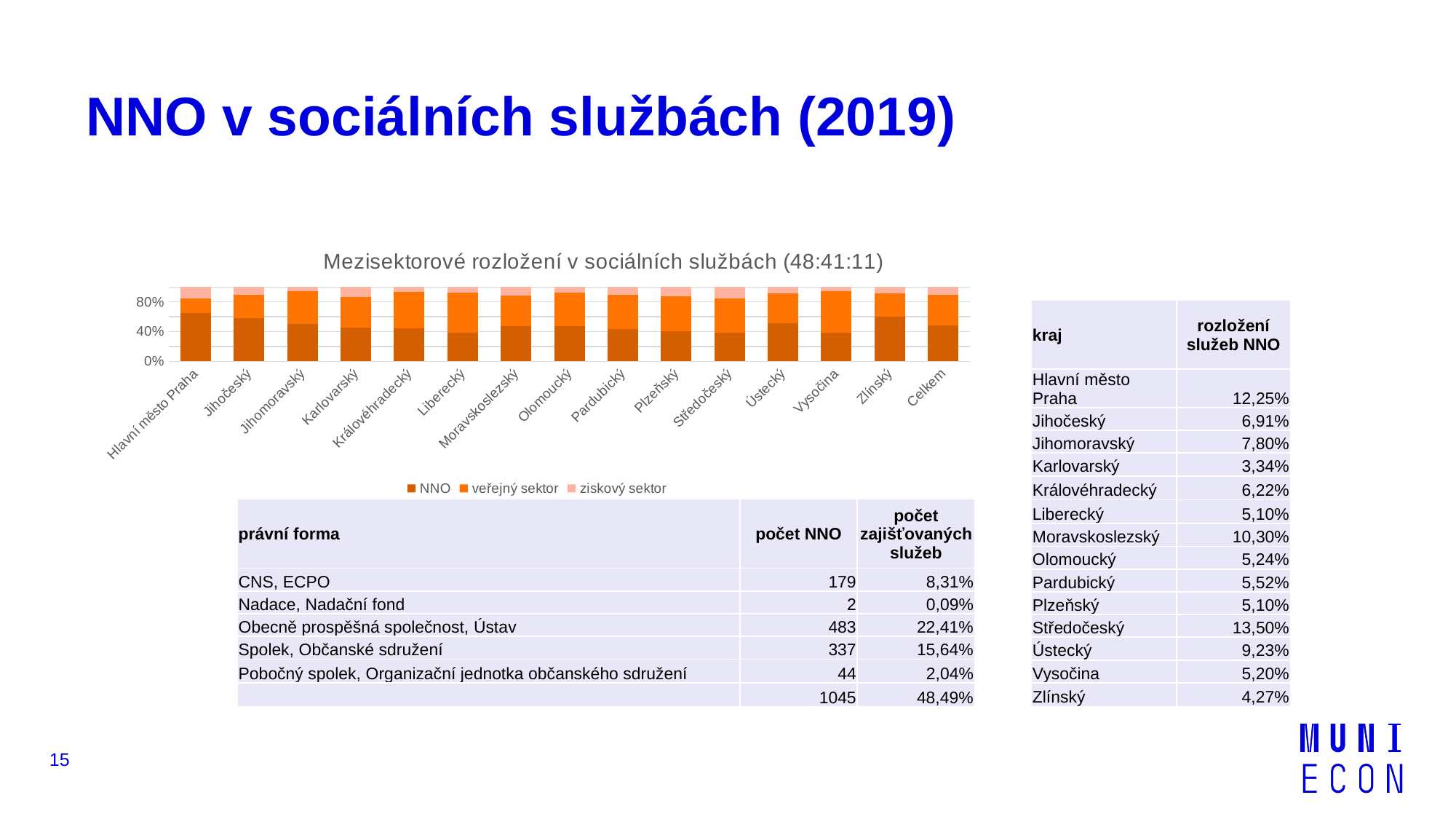
Is the NNO value for Hlavní město Praha greater or less than 40%? greater How many categories are shown on the x axis of the chart? 15 Which category has the highest NNO share in the chart? Hlavní město Praha Is the NNO value for Zlínský greater or less than 40%? greater Is the NNO value for Celkem greater or less than 80%? less Which has the larger NNO share: Jihomoravský or Liberecký? Jihomoravský What kind of chart is shown on the slide? stacked bar chart How many series does the chart legend list? 3 Which series is plotted at the bottom of each stacked bar? NNO Which has the larger NNO share: Hlavní město Praha or Karlovarský? Hlavní město Praha What is the title of the chart? Mezisektorové rozložení v sociálních službách (48:41:11)